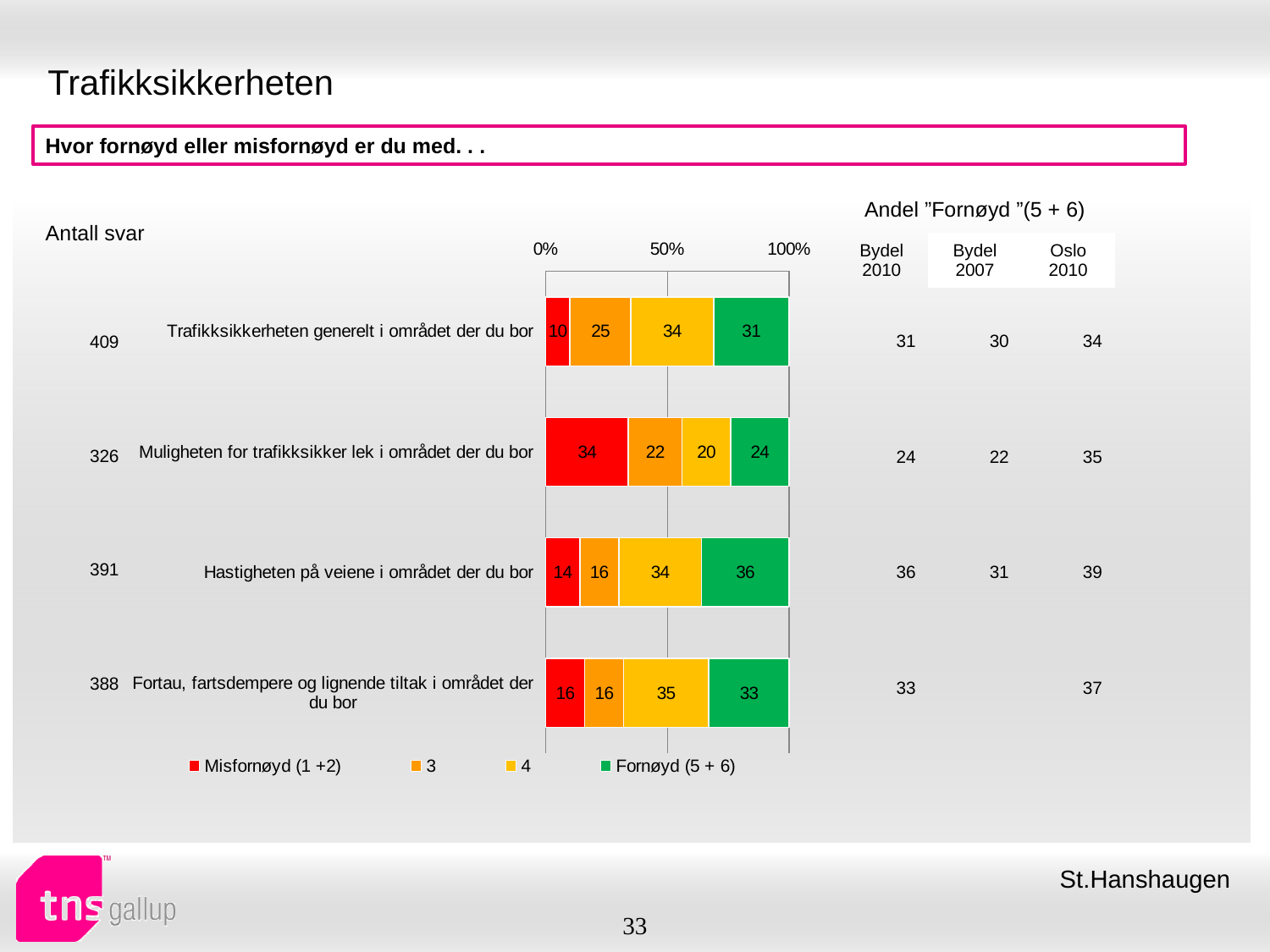
Which category has the lowest "Fornøyd (5 + 6)" value? Muligheten for trafikksikker lek i området der du bor Which category has the highest "Fornøyd (5 + 6)" value? Hastigheten på veiene i området der du bor What is the value of the "Fornøyd (5 + 6)" segment for "Hastigheten på veiene i området der du bor"? 36 What is the difference between the "Misfornøyd (1 +2)" values for "Muligheten for trafikksikker lek i området der du bor" and "Trafikksikkerheten generelt i området der du bor"? 24 How many categories are shown in the chart? 4 What is the value of the "4" segment for "Fortau, fartsdempere og lignende tiltak i området der du bor"? 35 What is the total of the stacked bar for "Trafikksikkerheten generelt i området der du bor"? 100 What is the value of the "Misfornøyd (1 +2)" segment for "Muligheten for trafikksikker lek i området der du bor"? 34 Which category has the lowest "Misfornøyd (1 +2)" value? Trafikksikkerheten generelt i området der du bor What kind of chart is shown on the slide? Stacked bar chart How many series does the legend list? 4 Which is larger: the "Fornøyd (5 + 6)" value for "Trafikksikkerheten generelt i området der du bor" or for "Muligheten for trafikksikker lek i området der du bor"? Trafikksikkerheten generelt i området der du bor